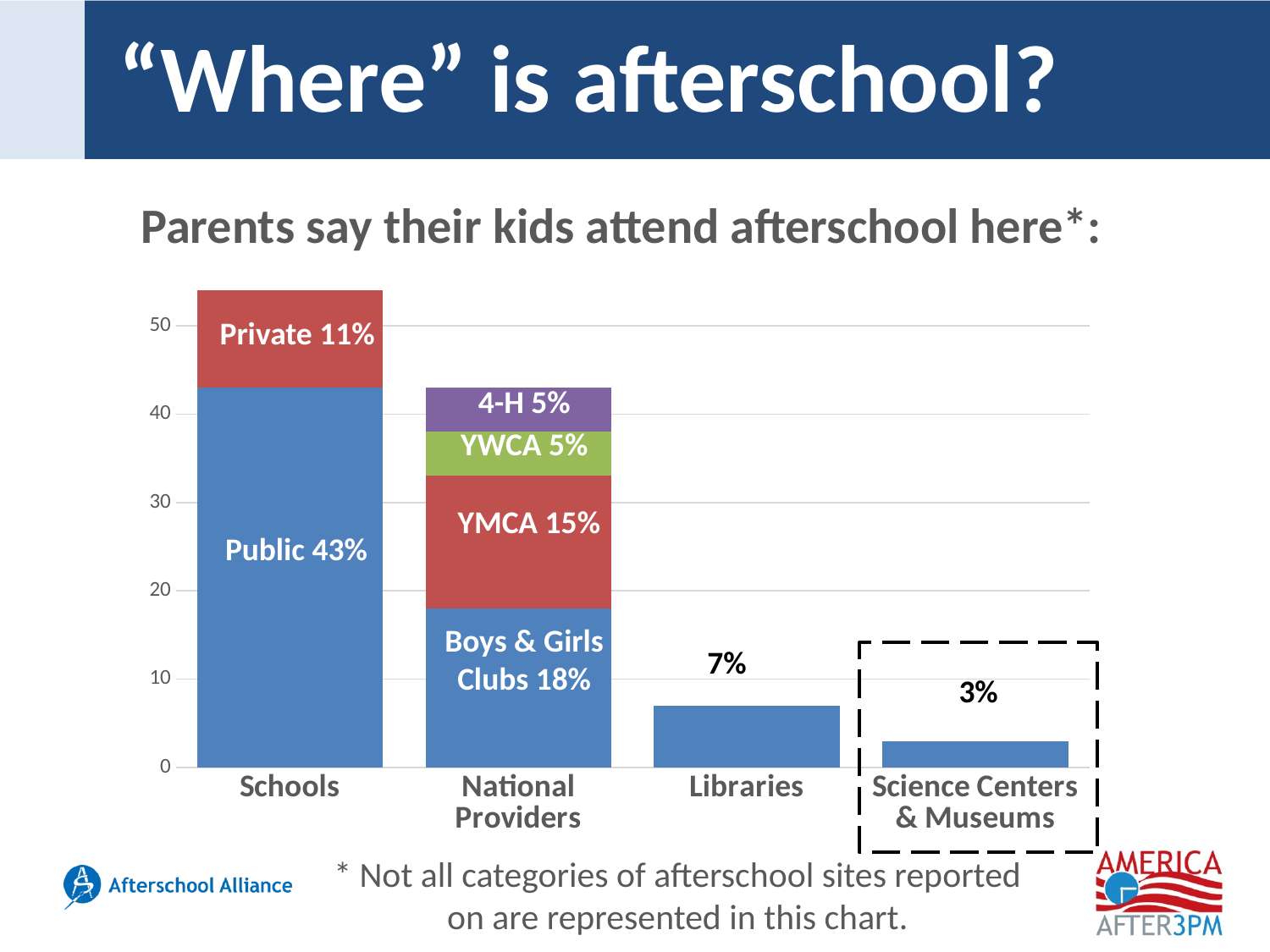
What is the value labelled for Science Centers & Museums? 3% What is the total of the stacked National Providers bar? 43% What is the total of the stacked Schools bar (Public plus Private)? 54% What kind of chart is shown on the slide? Stacked bar chart What is the difference between the Public and Private segments of the Schools bar? 32% What is the value labelled for Libraries? 7% What percentage of parents say their kids attend afterschool at public schools? 43% Which category has the tallest bar on the chart? Schools How many categories are shown along the x axis? 4 What percentage is shown for YMCA within the National Providers bar? 15% What percentage is shown for Boys & Girls Clubs? 18% Which category has the lowest value on the chart? Science Centers & Museums